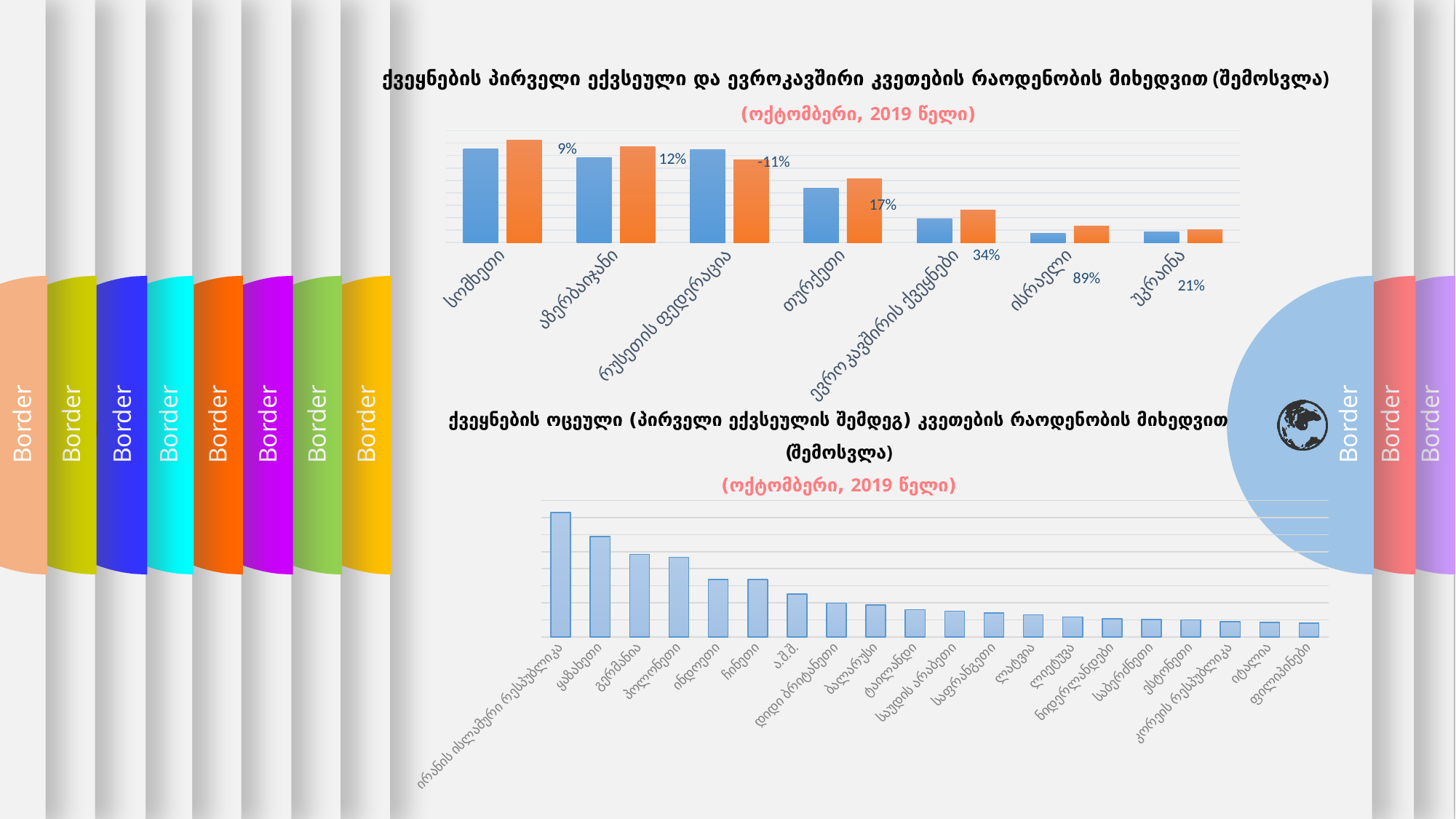
In the top chart, what percentage label is printed next to the bars for ევროკავშირის ქვეყნები? 34% In the bottom chart, how many countries are shown on the x axis? 20 In the bottom chart, which country has the tallest bar? ირანის ისლამური რესპუბლიკა What type of chart is the bottom chart on the slide? bar chart In the top chart, what percentage label is printed next to the bars for რუსეთის ფედერაცია? -11% In the top chart, which category has the tallest bars? სომხეთი What type of chart is the top chart on the slide? bar chart In the top chart, which has taller bars: სომხეთი or თურქეთი? სომხეთი In the top chart, how many countries/categories are shown on the x axis? 7 In the bottom chart, which bar is taller: ყაზახეთი or გერმანია? ყაზახეთი In the top chart, what percentage label is printed next to the bars for ისრაელი? 89% In the bottom chart, do the bar heights rise or fall from left to right? fall